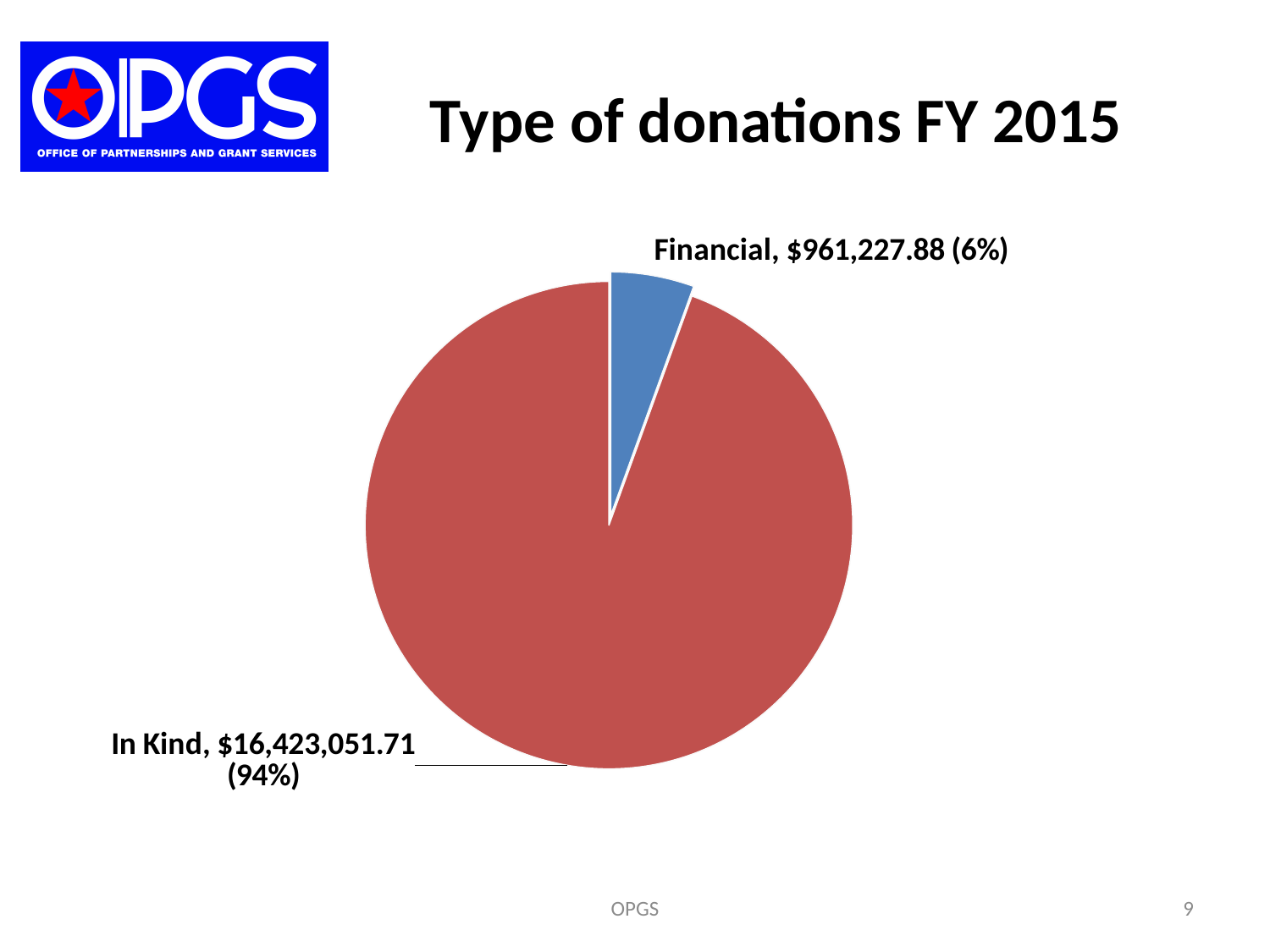
Which type of donation is the largest? In Kind What is the value of the In Kind slice? $16,423,051.71 What is the difference between In Kind and Financial donations? $15,461,823.83 What share of the pie does the In Kind slice represent? 94% How many slices does the pie chart have? 2 Which type of donation is the smallest? Financial What is the title of the chart? Type of donations FY 2015 What is the value of the Financial slice? $961,227.88 What colour is the In Kind slice? Red Which is larger, Financial or In Kind donations? In Kind What kind of chart is shown on the slide? Pie chart What share of the pie does the Financial slice represent? 6%